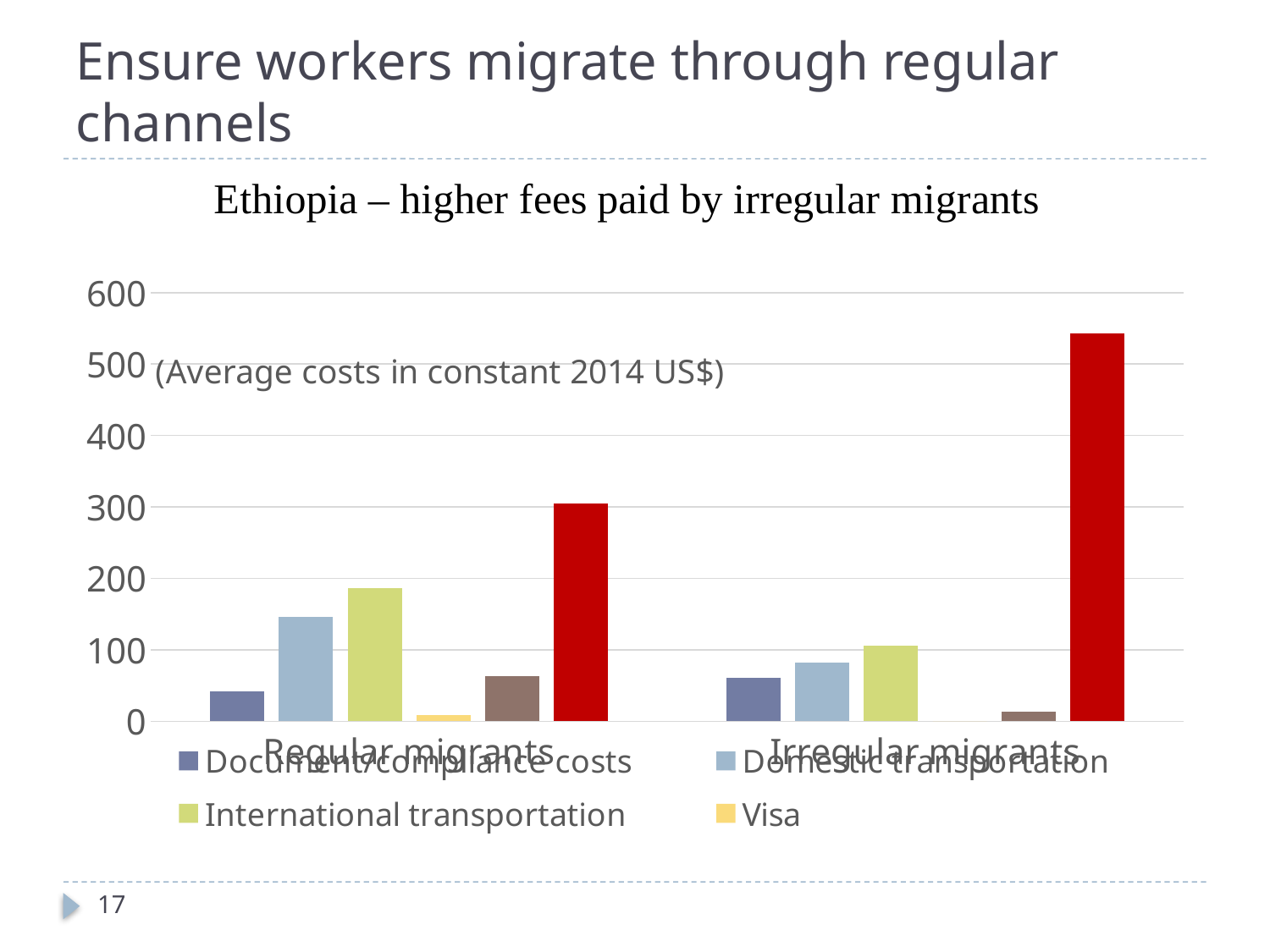
Which category has the larger value for Domestic transportation, Regular migrants or Irregular migrants? Regular migrants Is the value for Document/compliance costs for Regular migrants greater or less than 100? less In what units are the costs in the chart expressed, according to the note on the chart? Average costs in constant 2014 US$ How many categories are shown on the x axis of the chart? 2 Is the value for International transportation for Regular migrants greater or less than 200? less Is the value for Domestic transportation for Irregular migrants greater or less than 100? less What kind of chart is shown on the slide? bar chart Which category has the larger value for International transportation, Regular migrants or Irregular migrants? Regular migrants What is the title of the chart? Ethiopia – higher fees paid by irregular migrants How many series does the chart's legend list? 4